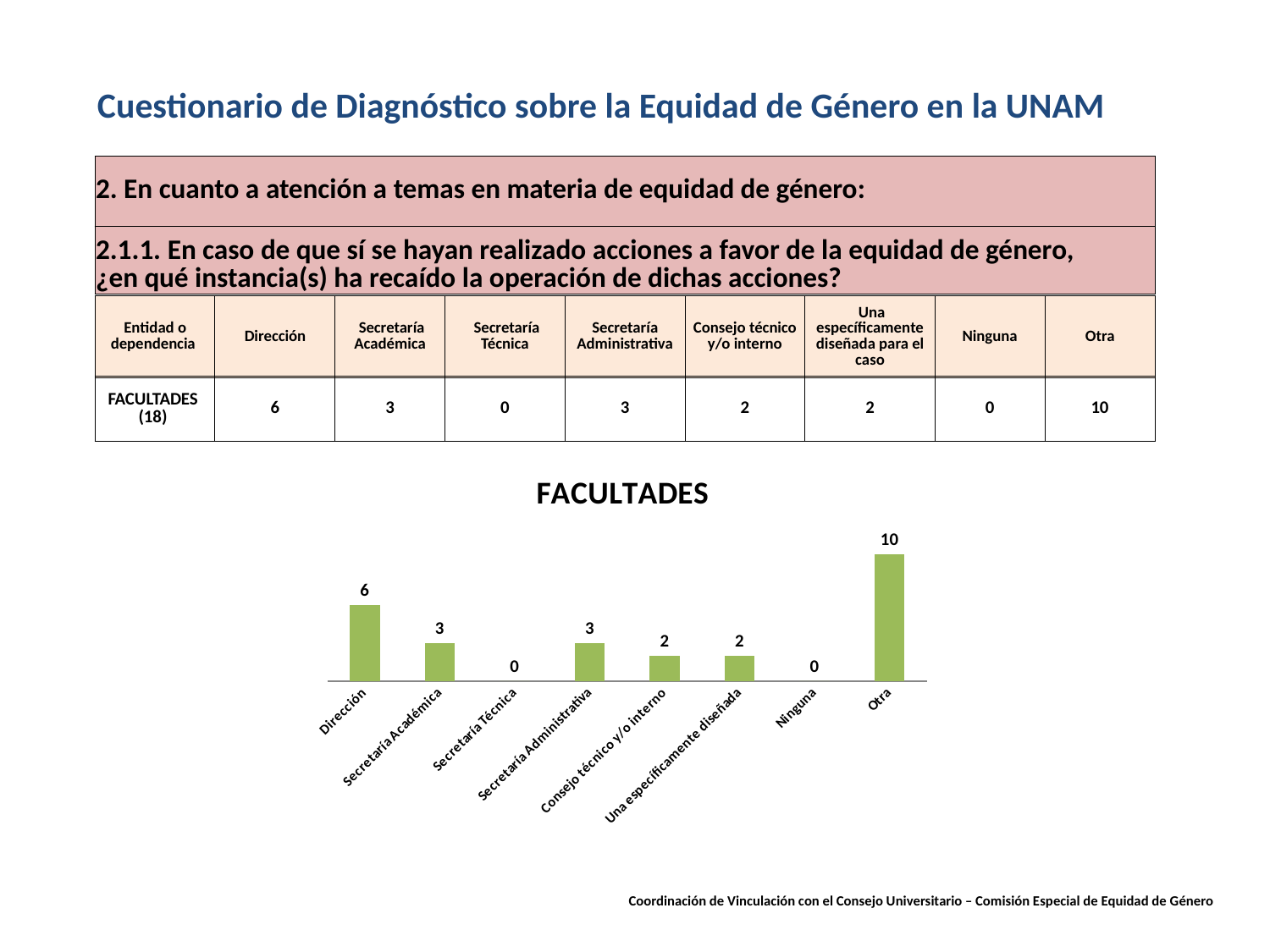
What is the difference between the values for Otra and Dirección in the FACULTADES chart? 4 What is the value for Secretaría Administrativa in the FACULTADES chart? 3 What kind of chart is the FACULTADES chart? Bar chart Which category has the highest value in the FACULTADES chart? Otra What is the value for Otra in the FACULTADES chart? 10 Which categories have a value of 0 in the FACULTADES chart? Secretaría Técnica and Ninguna What is the value for Dirección in the FACULTADES chart? 6 What is the title of the chart on the slide? FACULTADES What is the value for Consejo técnico y/o interno in the FACULTADES chart? 2 Which is larger in the FACULTADES chart, Dirección or Secretaría Académica? Dirección How many categories are shown on the x axis of the FACULTADES chart? 8 What colour are the bars in the FACULTADES chart? Green